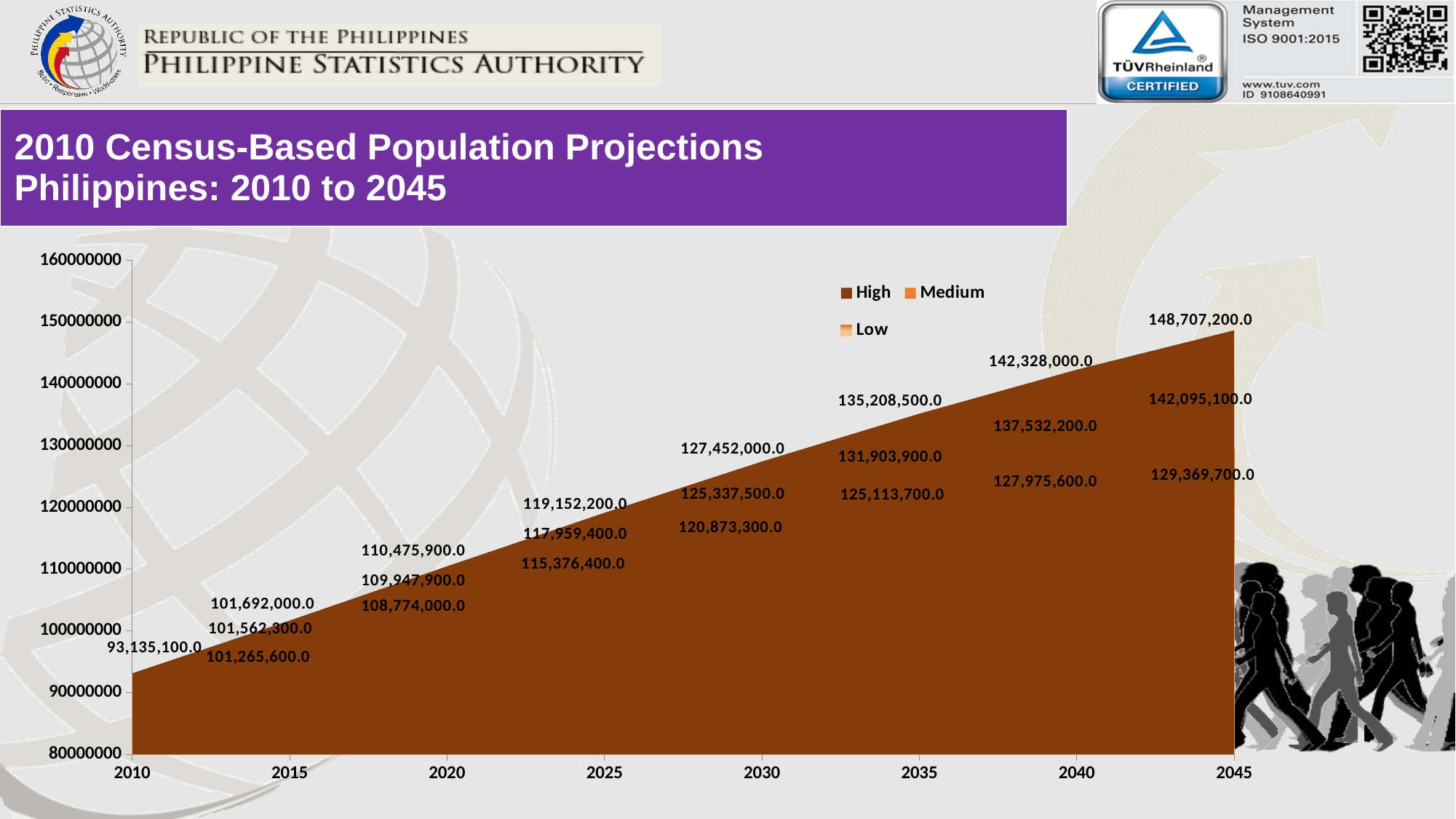
How many years are shown along the x axis? 8 What is the population value shown for 2010? 93,135,100.0 What is the Low projection for 2035? 125,113,700.0 Which series is listed first in the legend? High How many series does the legend list? 3 What is the difference between the High and Low projections for 2045? 19,337,500.0 Which is larger: the Medium projection for 2030 or the Low projection for 2035? Medium projection for 2030 What is the Medium projection for 2040? 137,532,200.0 By how much does the High projection for 2045 exceed the 2010 value? 55,572,100.0 What is the High projection for 2045? 148,707,200.0 What kind of chart is shown on the slide? Area chart Do the projected population values rise or fall from 2010 to 2045? Rise